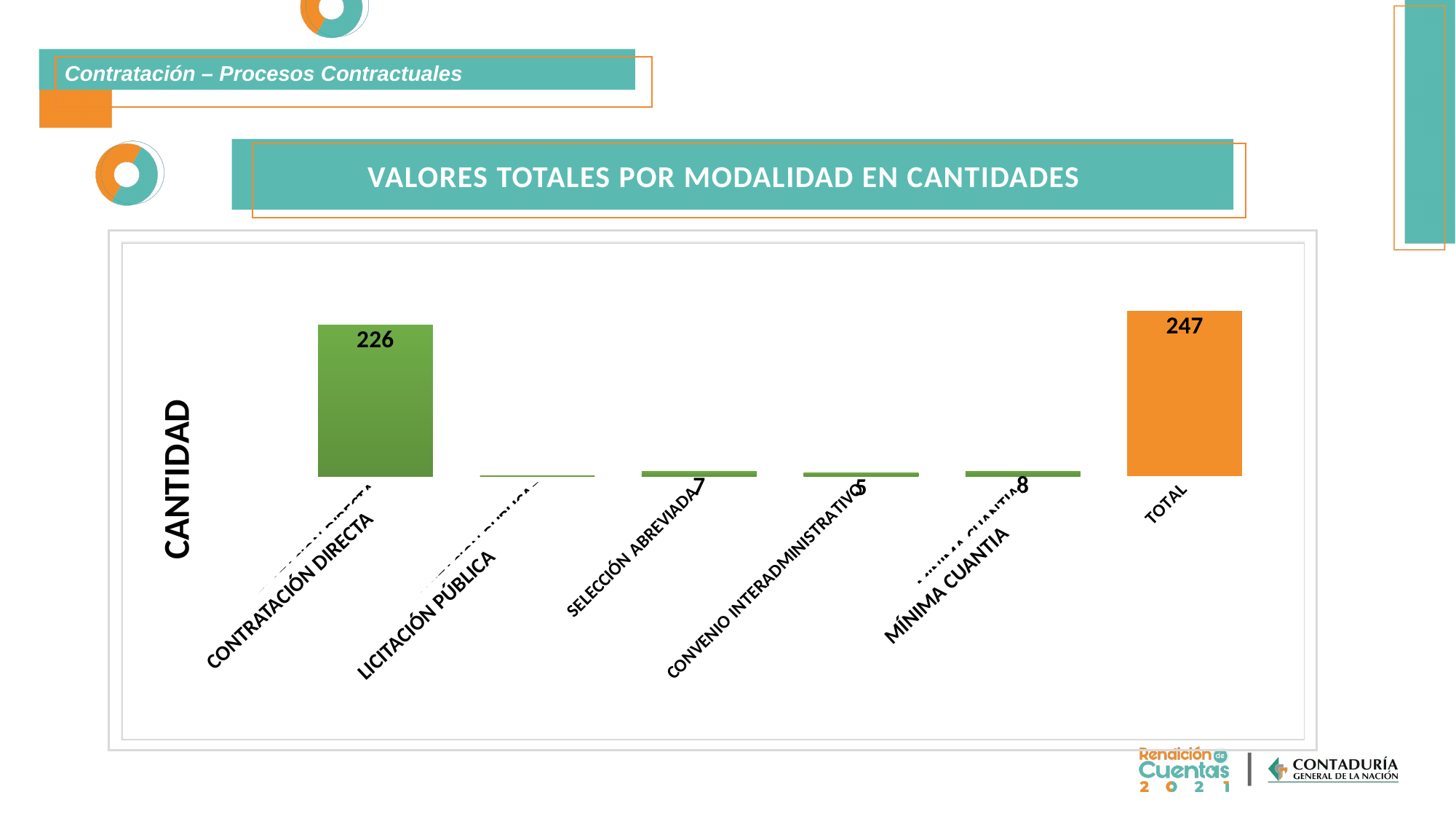
What is the value shown for CONVENIO INTERADMINISTRATIVO? 5 Which modality has the lowest bar in the chart? LICITACIÓN PÚBLICA What is the value shown for CONTRATACIÓN DIRECTA? 226 What kind of chart is shown on the slide? Bar chart How many bars are plotted in the chart? 6 What is the difference between the TOTAL value and the CONTRATACIÓN DIRECTA value? 21 What is the label on the vertical axis of the chart? CANTIDAD What is the value shown for SELECCIÓN ABREVIADA? 7 What is the value shown for MÍNIMA CUANTIA? 8 What is the value shown for the TOTAL bar? 247 Which is larger, the value for MÍNIMA CUANTIA or the value for CONVENIO INTERADMINISTRATIVO? MÍNIMA CUANTIA Excluding the TOTAL bar, which modality has the highest count? CONTRATACIÓN DIRECTA